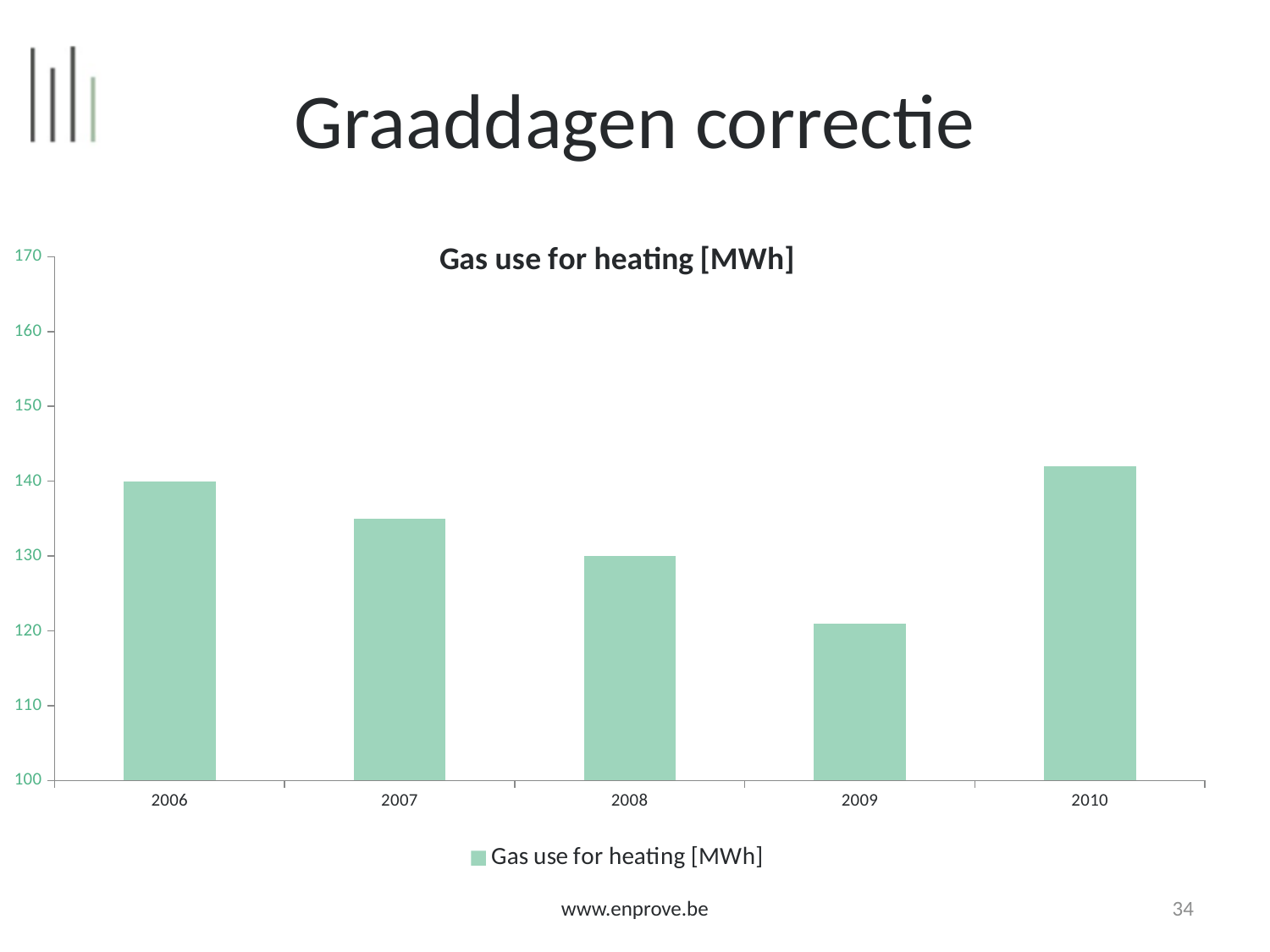
Which year has the highest gas use for heating? 2010 Is the gas use for heating in 2010 greater or less than 140? greater Is the gas use for heating in 2007 greater or less than 130? greater Is the gas use for heating in 2008 greater or less than 140? less What is the title of the chart? Gas use for heating [MWh] Which year has the lowest gas use for heating? 2009 What type of chart is shown on the slide? bar chart How many series does the legend list? 1 Does the gas use for heating rise or fall from 2006 to 2009? fall How many years are shown on the x axis of the chart? 5 Which year has a higher gas use for heating, 2006 or 2008? 2006